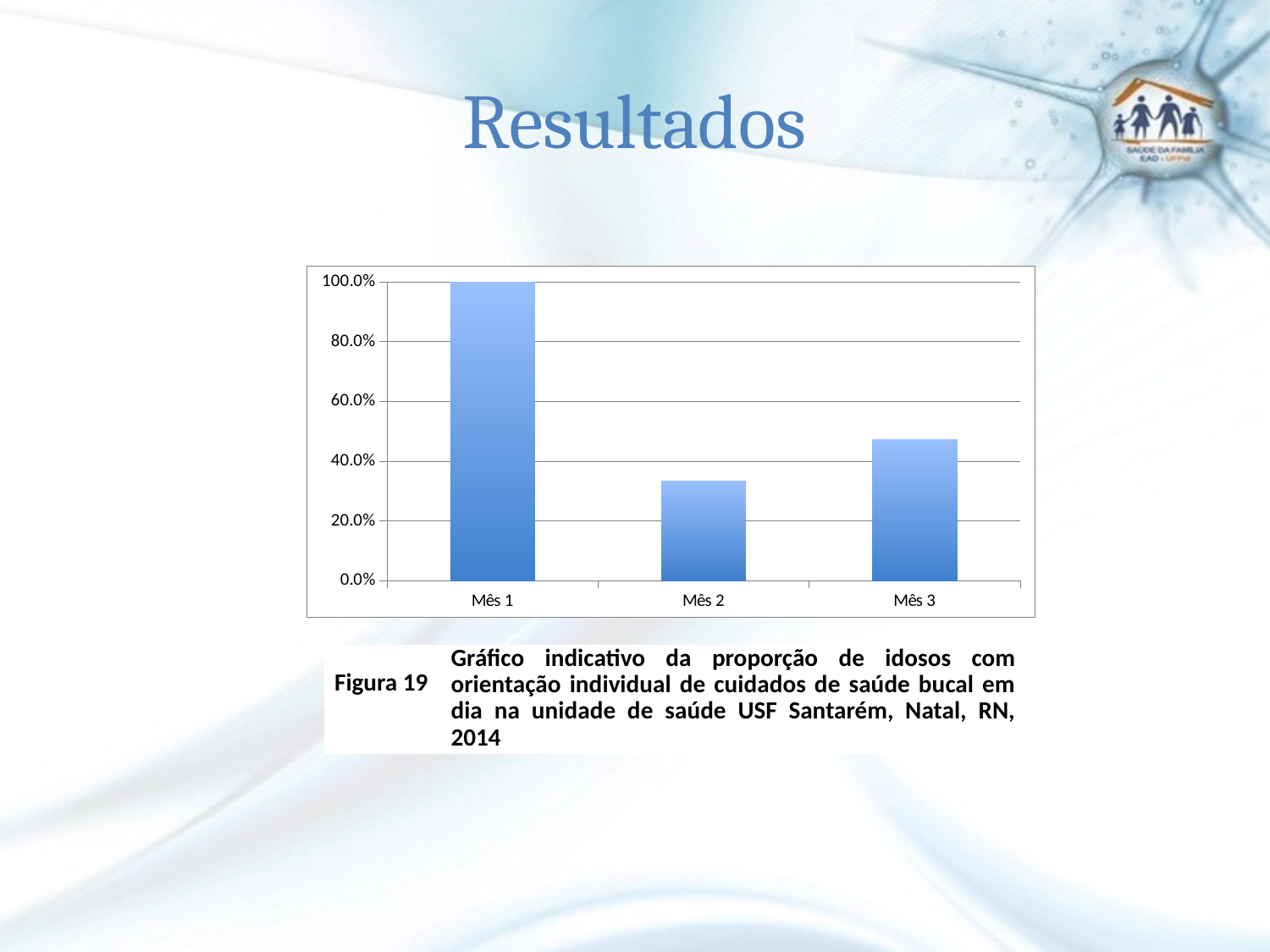
Which month has the highest value in the chart? Mês 1 What is the value for Mês 1? 100.0% What is the figure number given in the caption below the chart? Figura 19 How many categories are plotted on the x axis of the chart? 3 Which is larger, the value for Mês 2 or the value for Mês 3? Mês 3 What kind of chart is shown on the slide? bar chart What is the highest value shown on the y axis of the chart? 100.0% Is the value for Mês 2 greater or less than 20.0%? greater Is the value for Mês 2 greater or less than 40.0%? less Is the value for Mês 3 greater or less than 60.0%? less Which month has the lowest value in the chart? Mês 2